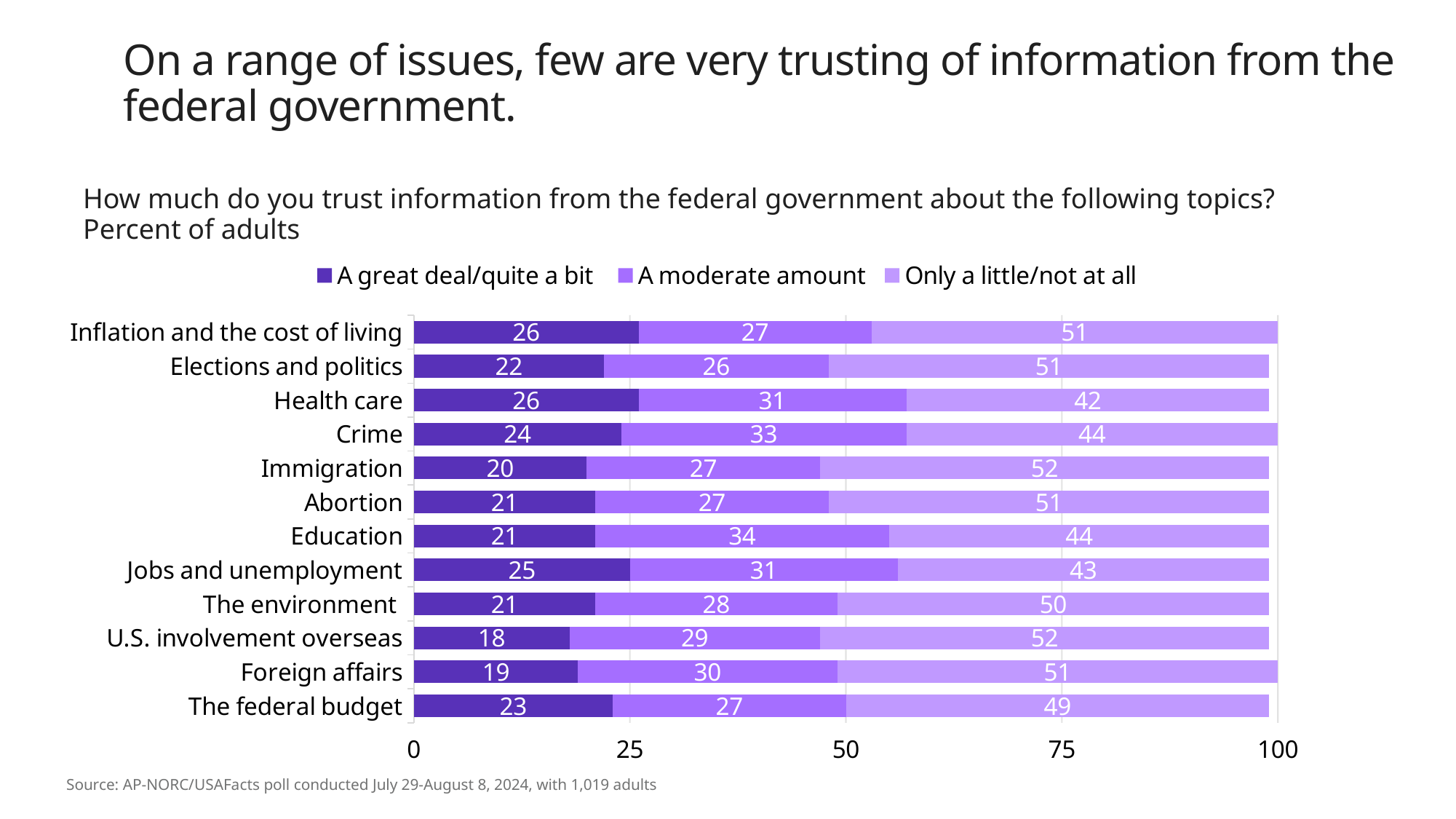
Which is larger: the 'A great deal/quite a bit' value for Jobs and unemployment or for Immigration? Jobs and unemployment How many series does the legend list? 3 Which topic has the lowest 'A great deal/quite a bit' value? U.S. involvement overseas What kind of chart is shown on the slide? Stacked bar chart What is the 'A great deal/quite a bit' value for The federal budget? 23 How many topics are shown in the chart? 12 What is the total of the three segments for Education? 99 What percentage of adults trust information about Crime 'A moderate amount'? 33 What is the difference between the 'A moderate amount' values for Crime and Inflation and the cost of living? 6 What is the 'Only a little/not at all' value for Health care? 42 Which topic has the highest 'A moderate amount' value? Education Which topic has the lowest 'Only a little/not at all' value? Health care